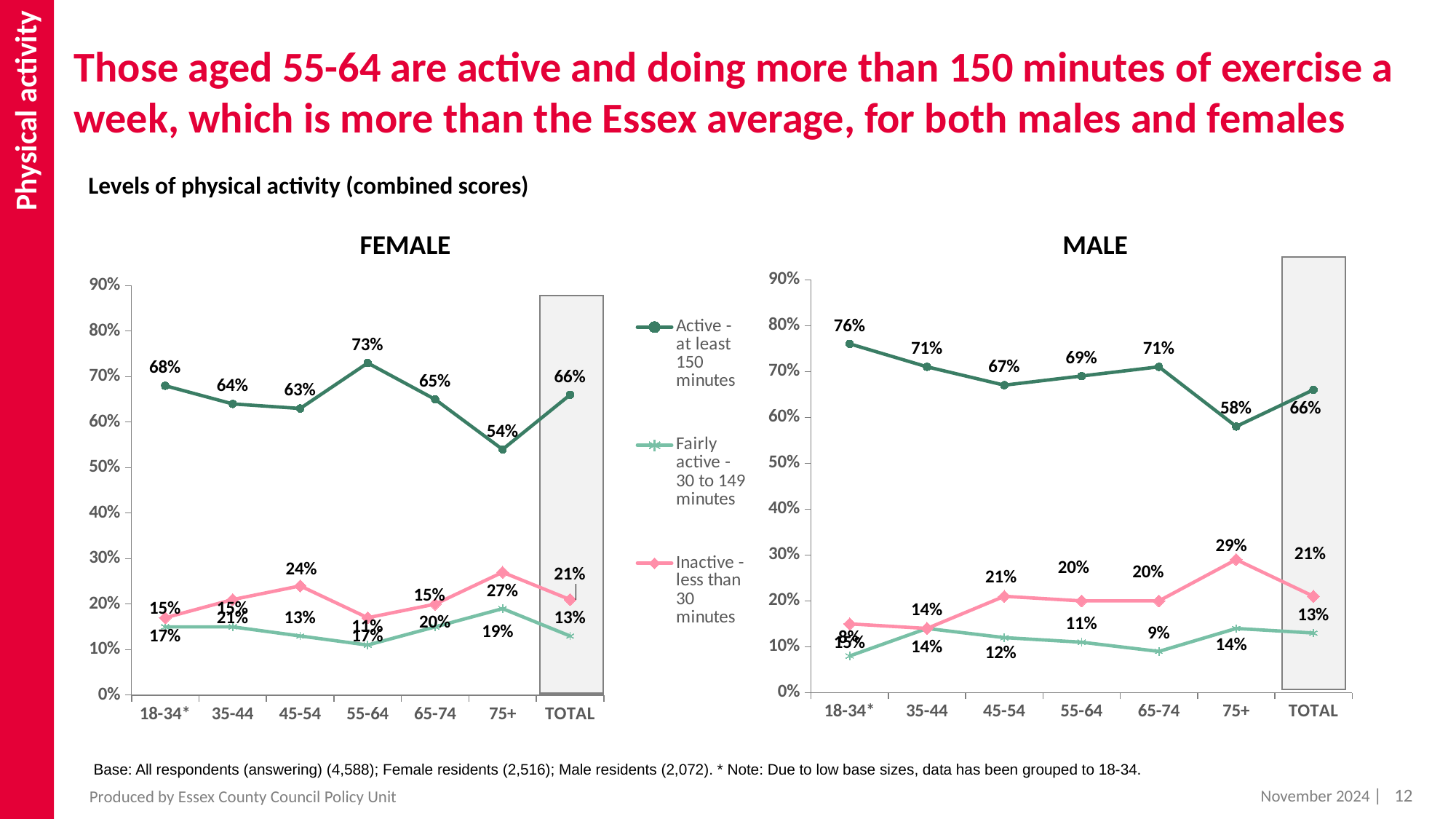
In the FEMALE chart, which is larger: the Inactive value for 45-54 or the Inactive value for 55-64? 45-54 In the MALE chart, what is the value for Inactive - less than 30 minutes for the 75+ age group? 29% In the FEMALE chart, what is the value for Active - at least 150 minutes for the 55-64 age group? 73% In the MALE chart, is the value for Active - at least 150 minutes for 45-54 greater or less than 60%? greater What is the TOTAL value for Fairly active - 30 to 149 minutes in the MALE chart? 13% In the MALE chart, does the Active - at least 150 minutes line rise or fall from 18-34* to 45-54? Fall In the MALE chart, which age group has the highest value for Active - at least 150 minutes? 18-34* In the MALE chart, what is the difference between the Active - at least 150 minutes values for 18-34* and 75+? 18% In the FEMALE chart, which age group has the lowest value for Active - at least 150 minutes? 75+ How many age-group categories (including TOTAL) are shown on the x axis of the FEMALE chart? 7 What type of chart is the MALE chart? Line chart How many series does the legend list? 3